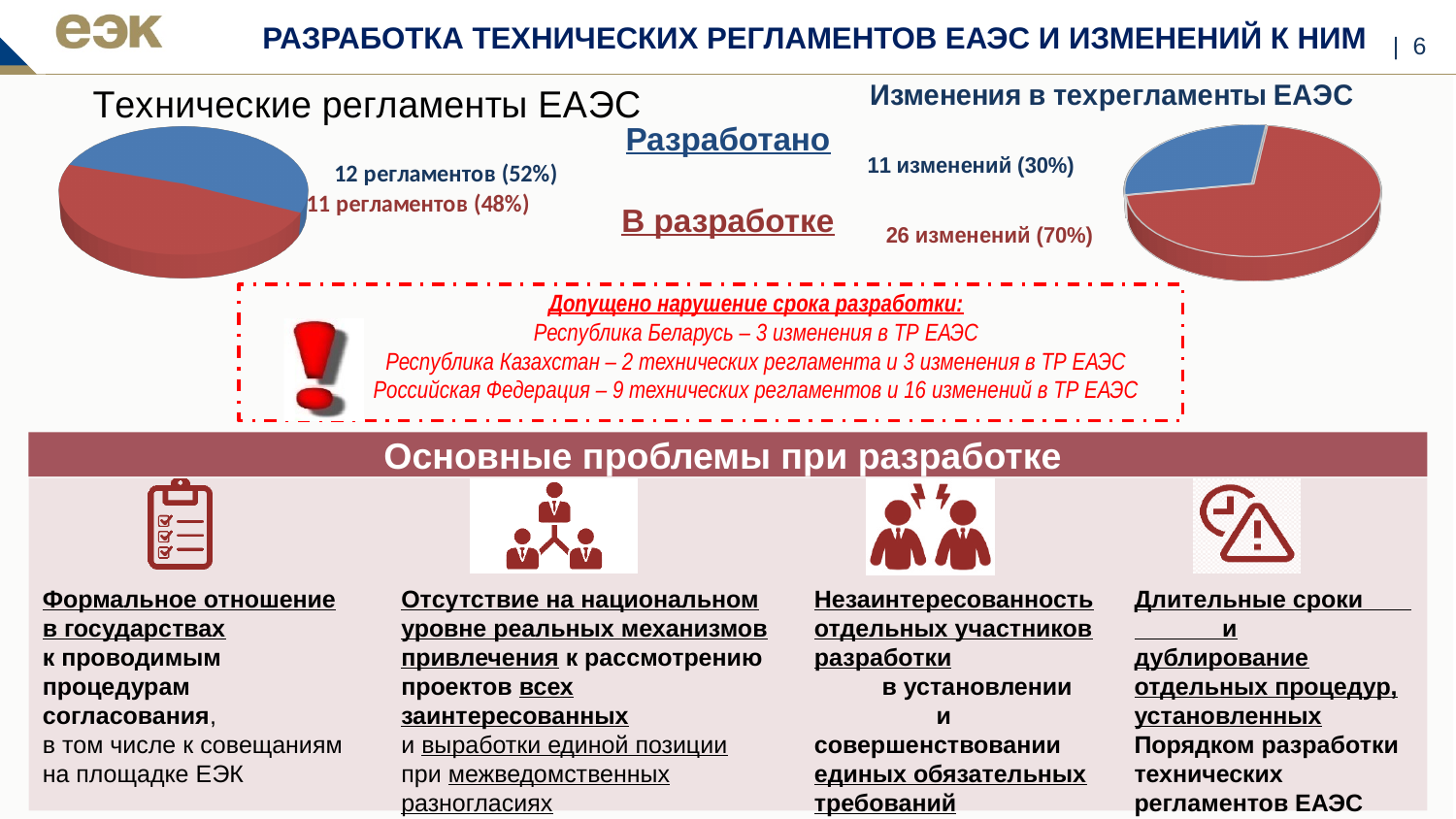
On the 'Технические регламенты ЕАЭС' pie chart, what is the total number of regulations across both slices? 23 On the 'Технические регламенты ЕАЭС' pie chart, how many regulations are shown as 'Разработано'? 12 регламентов (52%) What type of chart is used for 'Изменения в техрегламенты ЕАЭС'? Pie chart On the 'Изменения в техрегламенты ЕАЭС' pie chart, which category is the largest? В разработке On the 'Изменения в техрегламенты ЕАЭС' pie chart, how many changes are shown as 'Разработано'? 11 изменений (30%) On the 'Технические регламенты ЕАЭС' pie chart, how many regulations are shown as 'В разработке'? 11 регламентов (48%) On the 'Изменения в техрегламенты ЕАЭС' pie chart, how many changes are shown as 'В разработке'? 26 изменений (70%) On the 'Технические регламенты ЕАЭС' pie chart, what share of the pie is 'Разработано'? 52% How many slices does the 'Технические регламенты ЕАЭС' pie chart have? 2 On the 'Изменения в техрегламенты ЕАЭС' pie chart, which category is the smallest? Разработано On the 'Изменения в техрегламенты ЕАЭС' pie chart, what is the difference between the number of changes 'В разработке' and 'Разработано'? 15 On the 'Изменения в техрегламенты ЕАЭС' pie chart, what share of the pie is 'В разработке'? 70%